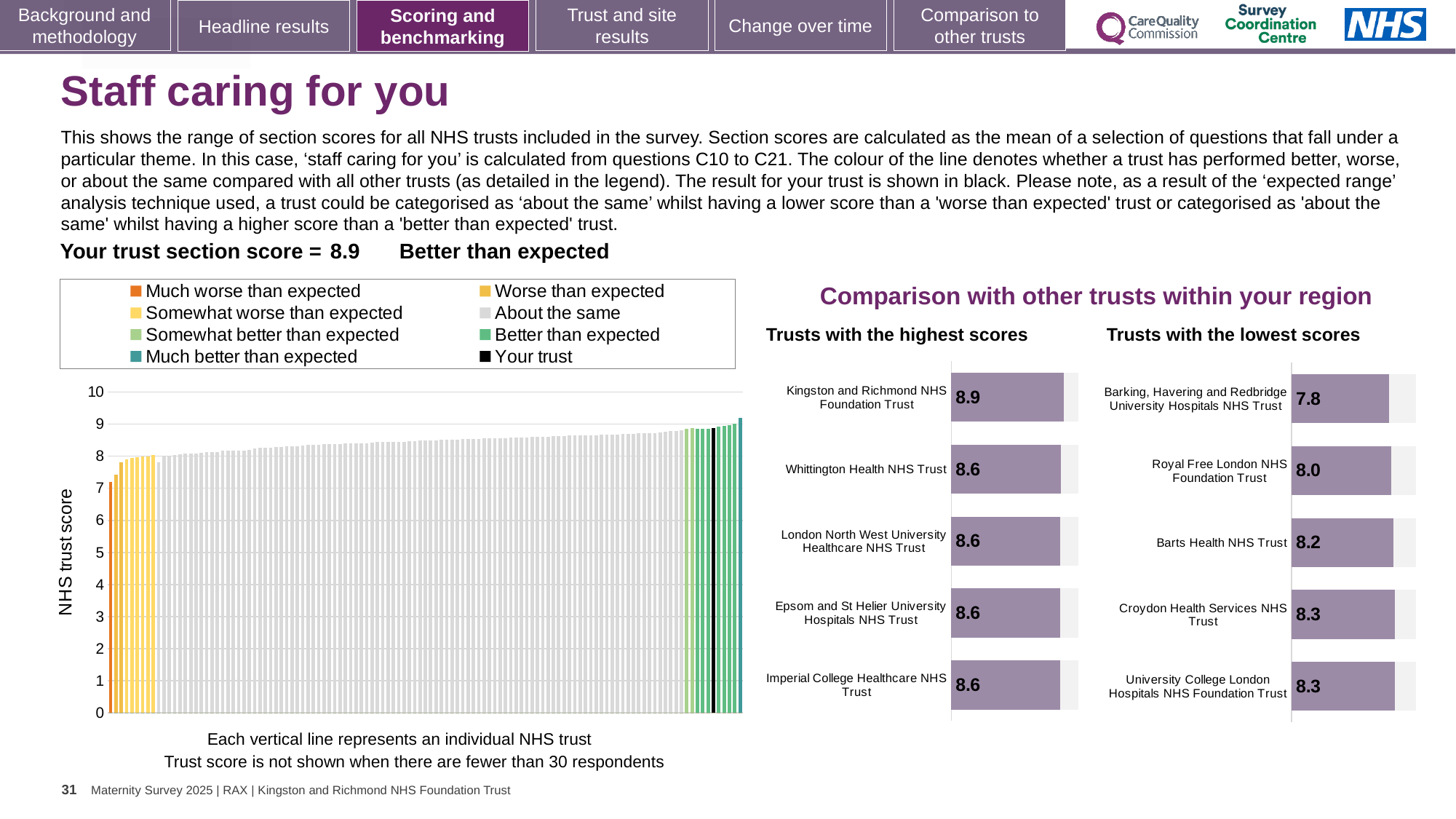
In the 'Trusts with the lowest scores' chart, what is the score for Barts Health NHS Trust? 8.2 In the 'Trusts with the highest scores' chart, what is the score for Kingston and Richmond NHS Foundation Trust? 8.9 In the 'Trusts with the highest scores' chart, what is the difference between the scores of Kingston and Richmond NHS Foundation Trust and Whittington Health NHS Trust? 0.3 In the 'Trusts with the lowest scores' chart, which trust has the lowest score? Barking, Havering and Redbridge University Hospitals NHS Trust What kind of chart is the 'Trusts with the lowest scores' chart? Bar chart In the 'Trusts with the lowest scores' chart, which has the larger score: Barts Health NHS Trust or Royal Free London NHS Foundation Trust? Barts Health NHS Trust In the 'Trusts with the highest scores' chart, which trust has the highest score? Kingston and Richmond NHS Foundation Trust How many trusts are listed in the 'Trusts with the highest scores' chart? 5 In the main 'NHS trust score' chart on the left, is the value of the lowest bar greater or less than 8? less In the 'Trusts with the lowest scores' chart, what is the difference between the scores of Royal Free London NHS Foundation Trust and Barking, Havering and Redbridge University Hospitals NHS Trust? 0.2 In the 'Trusts with the lowest scores' chart, what is the score for Barking, Havering and Redbridge University Hospitals NHS Trust? 7.8 How many entries does the legend of the main 'NHS trust score' chart list? 8